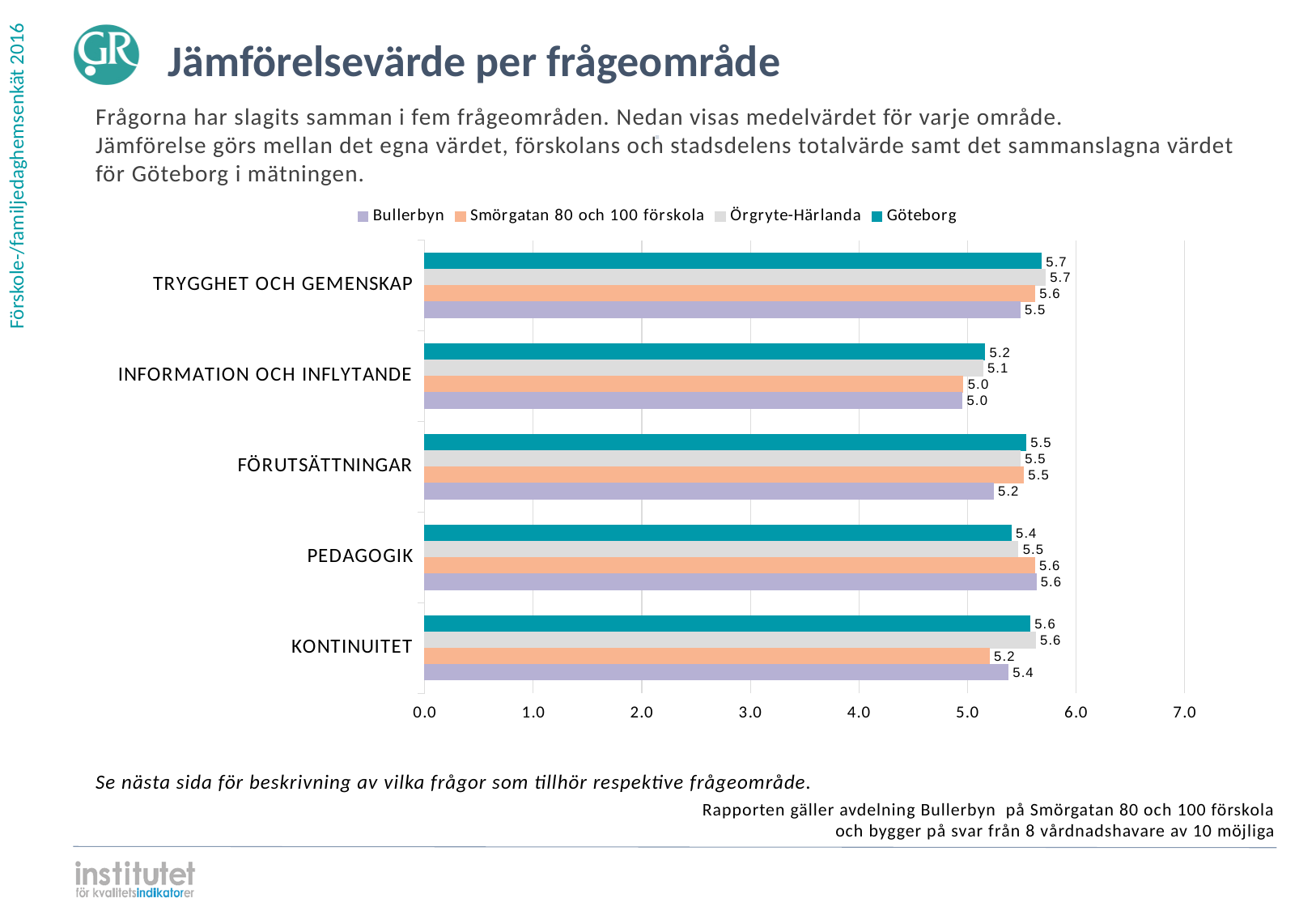
What is the value for Göteborg in the INFORMATION OCH INFLYTANDE category? 5.2 What is the value for Smörgatan 80 och 100 förskola in the KONTINUITET category? 5.2 Which series is shown in teal on the chart? Göteborg How many series does the legend list? 4 In the KONTINUITET category, which is larger: the value for Bullerbyn or the value for Smörgatan 80 och 100 förskola? Bullerbyn What is the value for Bullerbyn in the PEDAGOGIK category? 5.6 What is the value for Örgryte-Härlanda in the TRYGGHET OCH GEMENSKAP category? 5.7 In which category does Bullerbyn have its highest value? PEDAGOGIK What kind of chart is shown on the slide? Bar chart What is the difference between the Göteborg value and the Bullerbyn value in the FÖRUTSÄTTNINGAR category? 0.3 How many categories (frågeområden) are shown on the chart? 5 In which category does Göteborg have its lowest value? INFORMATION OCH INFLYTANDE